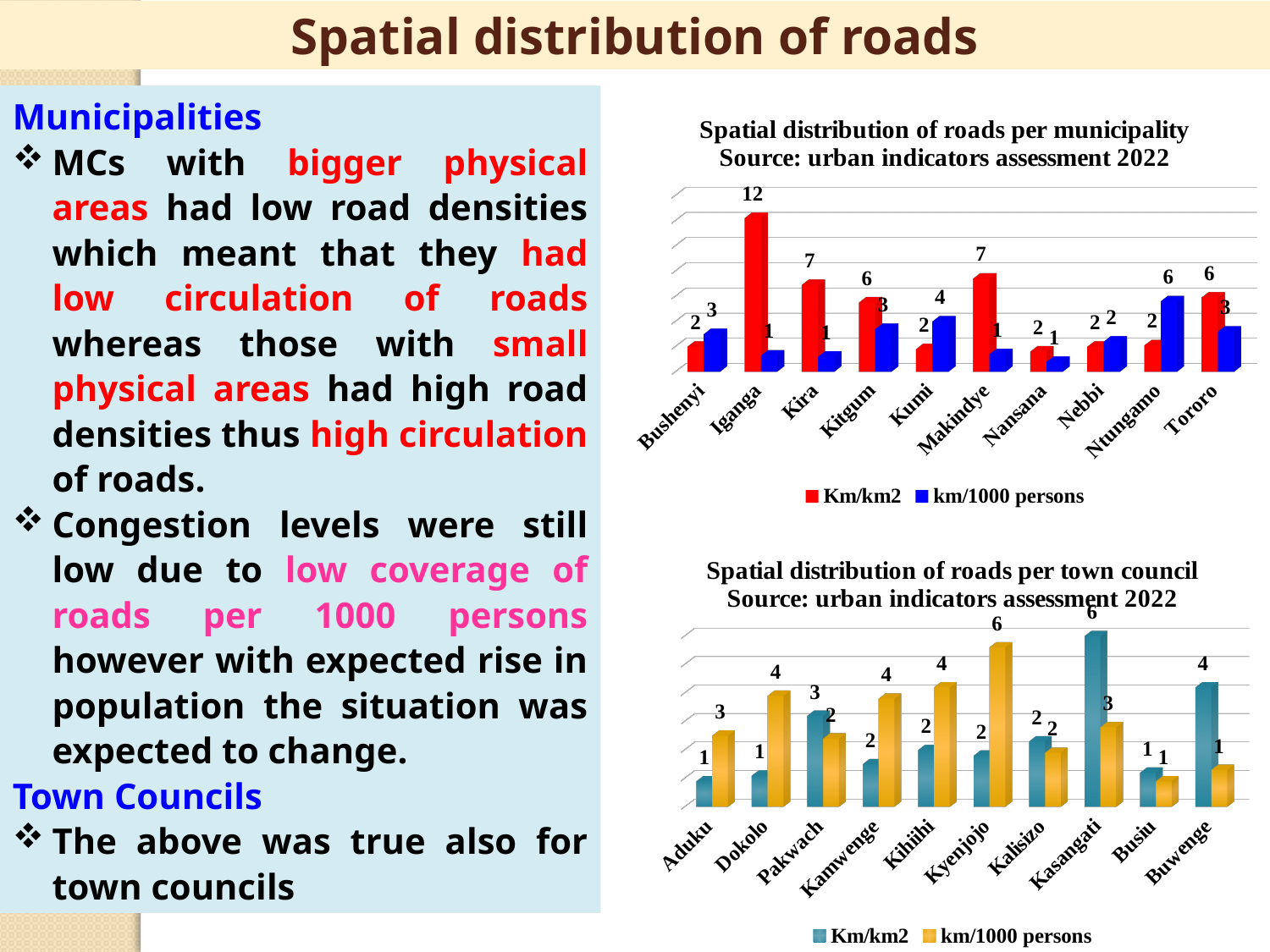
In the 'Spatial distribution of roads per town council' chart, what is the difference between the Km/km2 value and the km/1000 persons value for Kasangati? 3 In the 'Spatial distribution of roads per municipality' chart, which is larger for Kumi: Km/km2 or km/1000 persons? km/1000 persons In the 'Spatial distribution of roads per municipality' chart, how many series does the legend list? 2 What kind of chart is the 'Spatial distribution of roads per town council' chart? Bar chart In the 'Spatial distribution of roads per municipality' chart, how many municipalities are shown on the x axis? 10 In the 'Spatial distribution of roads per town council' chart, what is the km/1000 persons value for Kyenjojo? 6 In the 'Spatial distribution of roads per municipality' chart, what is the difference between the Km/km2 value and the km/1000 persons value for Iganga? 11 In the 'Spatial distribution of roads per municipality' chart, which municipality has the highest Km/km2 value? Iganga In the 'Spatial distribution of roads per town council' chart, which town council has the highest Km/km2 value? Kasangati In the 'Spatial distribution of roads per town council' chart, what colour represents the km/1000 persons series? Yellow In the 'Spatial distribution of roads per municipality' chart, what is the Km/km2 value for Iganga? 12 In the 'Spatial distribution of roads per municipality' chart, which municipality has the highest km/1000 persons value? Ntungamo